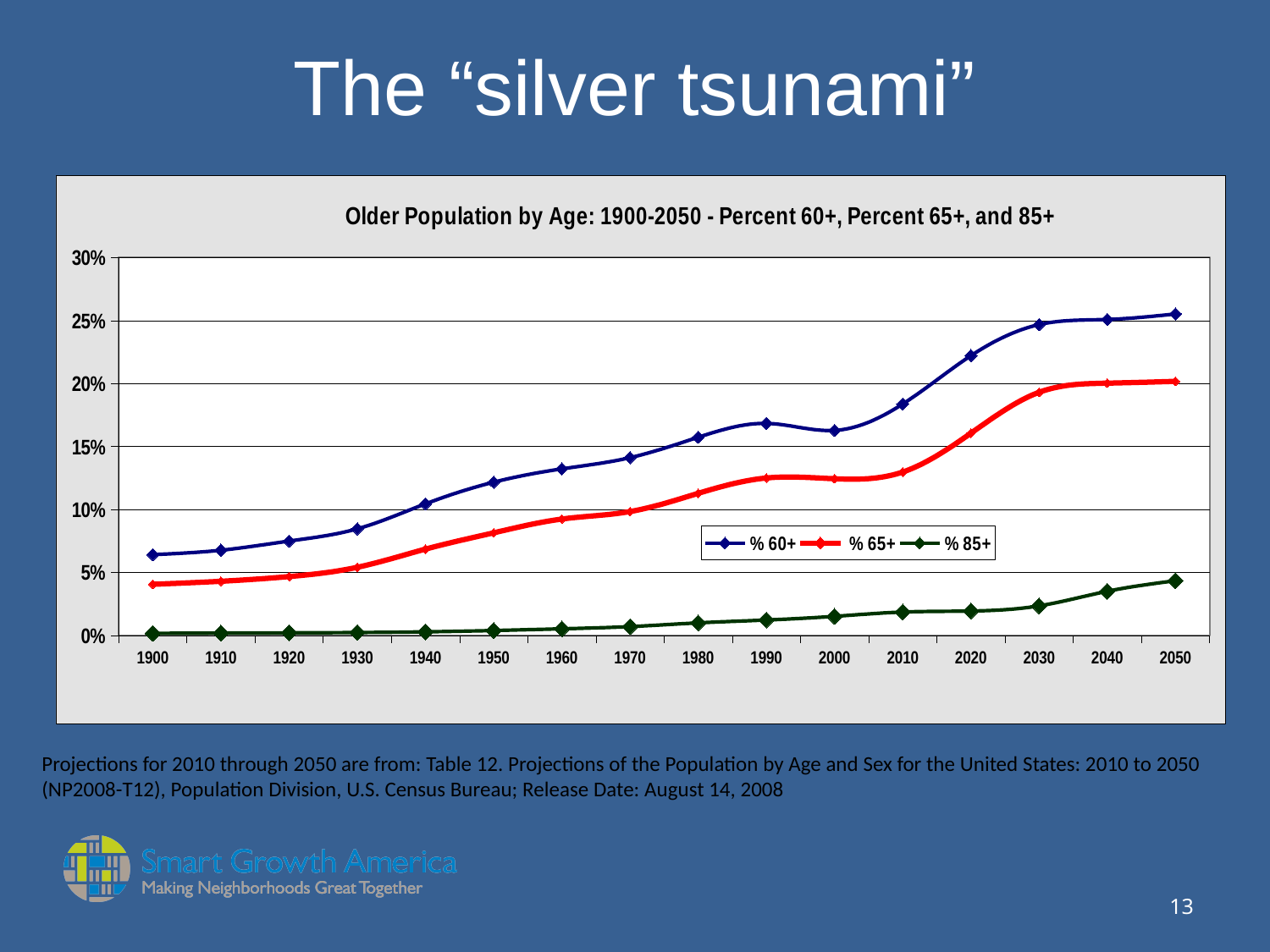
How many series does the chart legend list? 3 What is the title of the chart? Older Population by Age: 1900-2050 - Percent 60+, Percent 65+, and 85+ In 2000, which is larger: the value for % 60+ or the value for % 65+? % 60+ What kind of chart is shown on the slide? line chart Which series has the highest values across the chart? % 60+ Is the value for % 65+ in 1900 greater or less than 5%? less How many years are plotted along the x axis of the chart? 16 Is the value for % 85+ in 2050 greater or less than 5%? less In which year does the % 60+ series reach its highest value? 2050 Is the value for % 60+ in 2020 greater or less than 20%? greater Do the values for % 65+ generally rise or fall from 1900 to 2050? rise